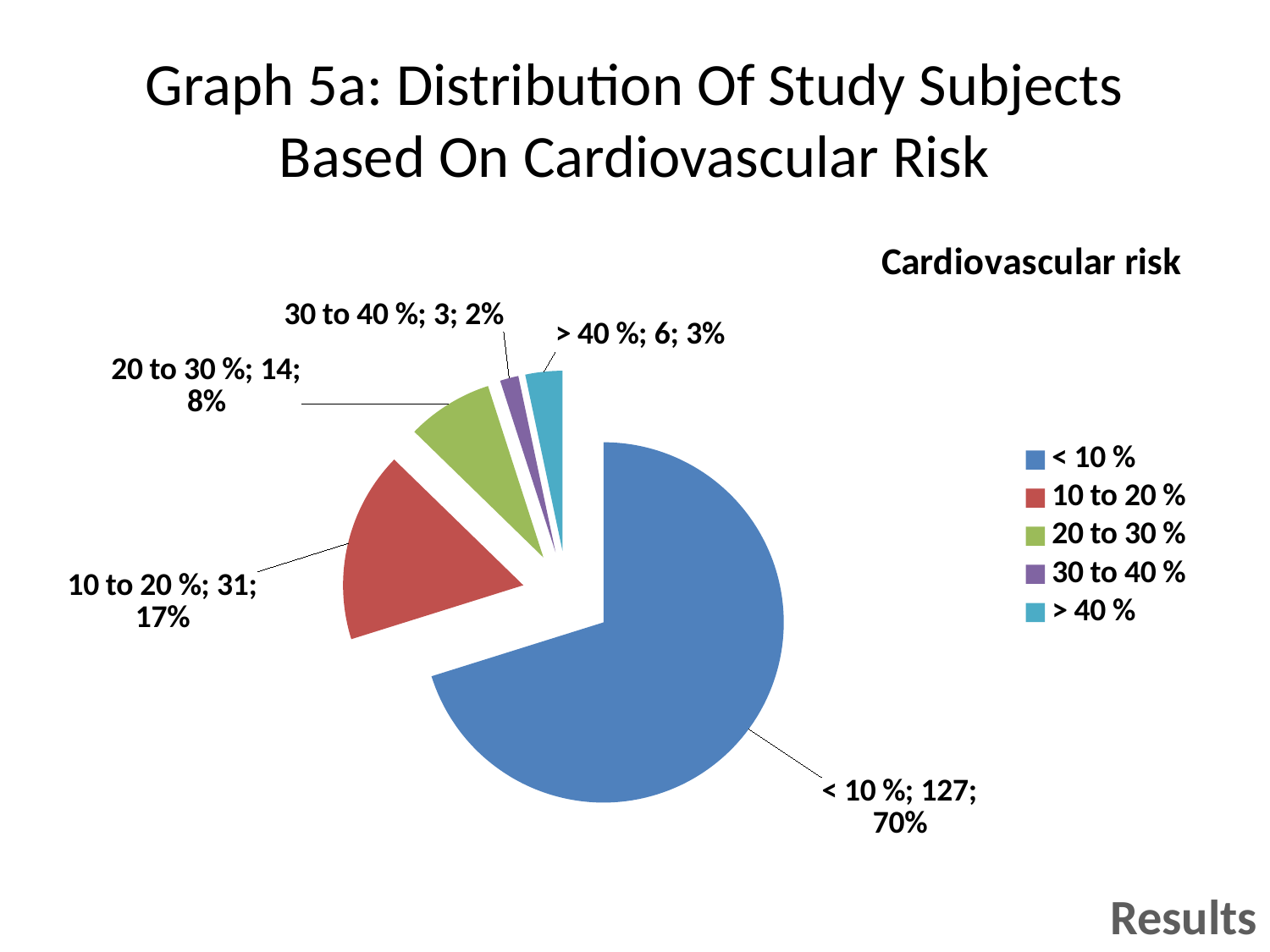
What type of chart is shown on the slide? pie chart How many study subjects are in the < 10 % cardiovascular risk category? 127 What share of the pie does the 30 to 40 % category represent? 2% How many categories does the legend list? 5 How many study subjects are in the > 40 % cardiovascular risk category? 6 Which cardiovascular risk category has the smallest number of study subjects? 30 to 40 % What is the difference in the number of study subjects between the < 10 % and 10 to 20 % categories? 96 Which cardiovascular risk category has the largest number of study subjects? < 10 % What share of the pie does the < 10 % category represent? 70% Which category has more study subjects, 20 to 30 % or > 40 %? 20 to 30 % How many study subjects are in the 20 to 30 % cardiovascular risk category? 14 How many study subjects are in the 10 to 20 % cardiovascular risk category? 31